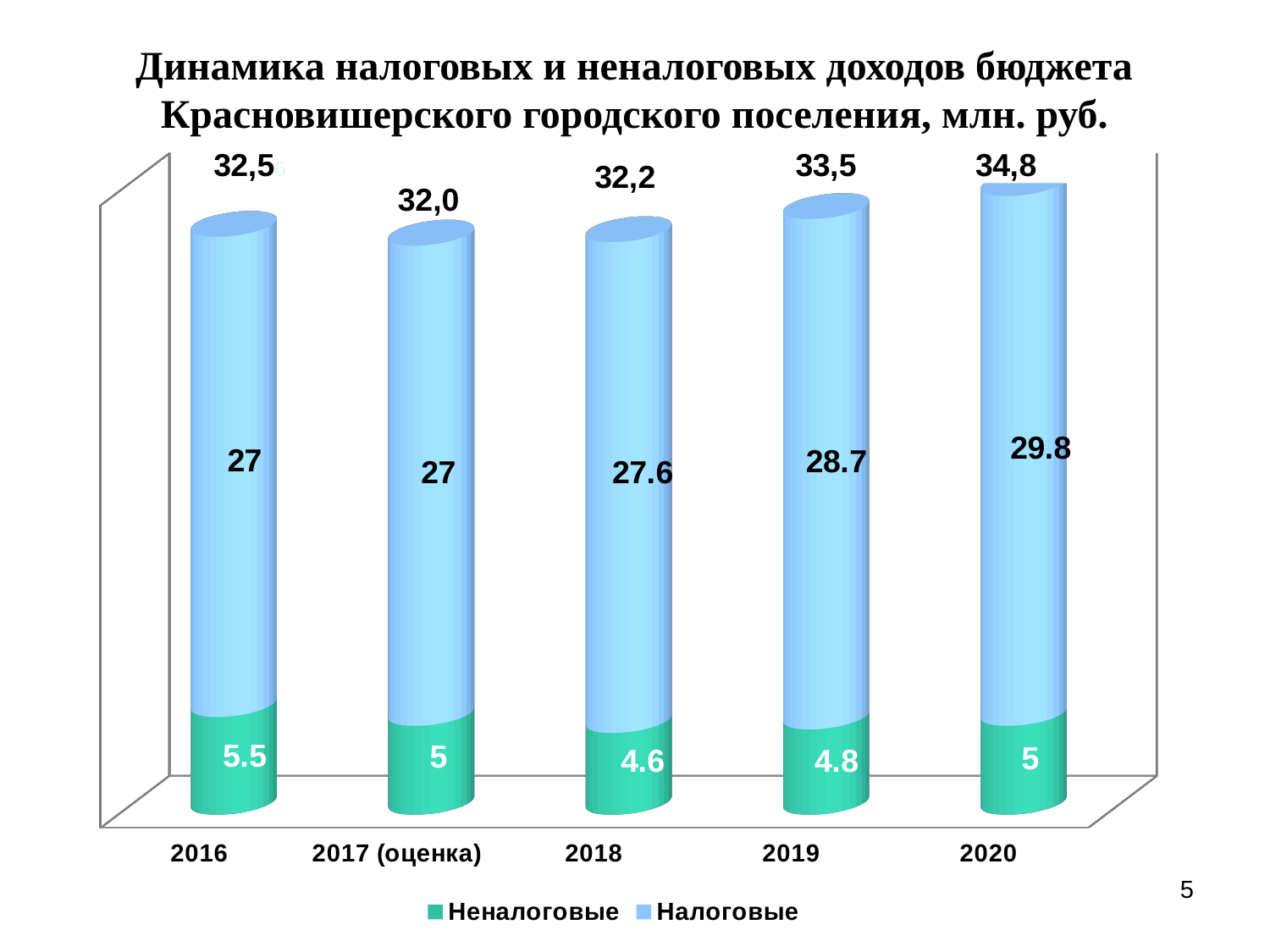
What kind of chart is shown on the slide? Stacked bar chart What is the total of the stacked bar for 2019? 33,5 How many years are shown on the x axis? 5 Which is larger, the Неналоговые value for 2016 or for 2019? 2016 What is the difference between the Налоговые values for 2020 and 2016? 2.8 What is the value for Налоговые in 2019? 28.7 Which year has the lowest value for Неналоговые? 2018 How many series does the legend list? 2 What is the value for Неналоговые in 2016? 5.5 Which year has the highest value for Налоговые? 2020 What is the value for Налоговые in 2020? 29.8 What is the value for Неналоговые in 2018? 4.6